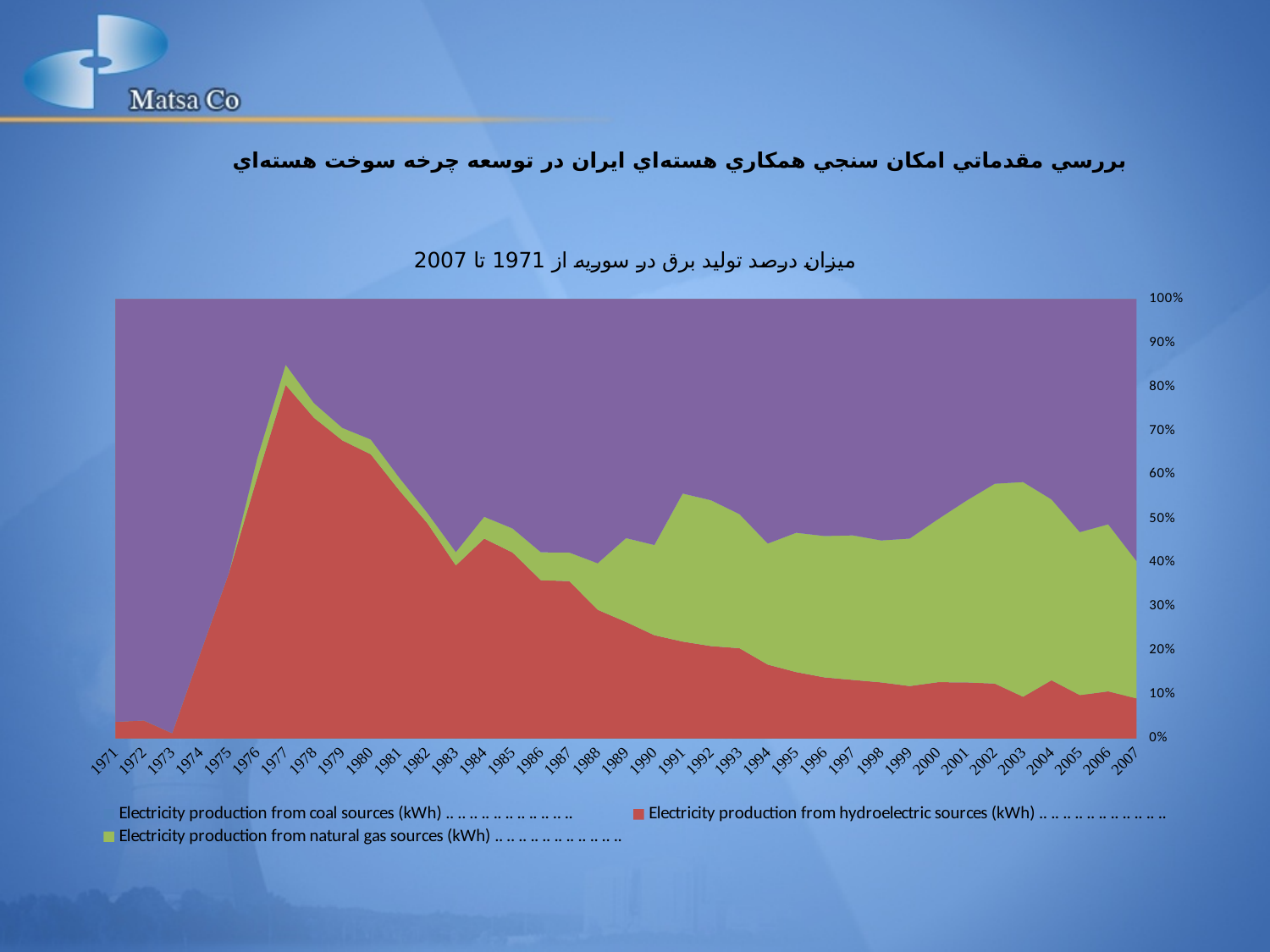
How many series does the legend list? 3 Does the share of electricity production from hydroelectric sources rise or fall from 1977 to 2007? fall Does the share of electricity production from hydroelectric sources rise or fall from 1973 to 1977? rise Is the share of electricity production from hydroelectric sources in 1977 greater or less than 70%? greater Which year has the larger share of electricity production from hydroelectric sources, 1980 or 1990? 1980 Is the share of electricity production from hydroelectric sources in 1971 greater or less than 10%? less Is the share of electricity production from hydroelectric sources in 2007 greater or less than 20%? less What is the last year shown on the x axis? 2007 In which year does the share of electricity production from hydroelectric sources reach its highest point? 1977 How many years are shown along the x axis? 37 What kind of chart is shown on the slide? area chart What is the first year shown on the x axis? 1971